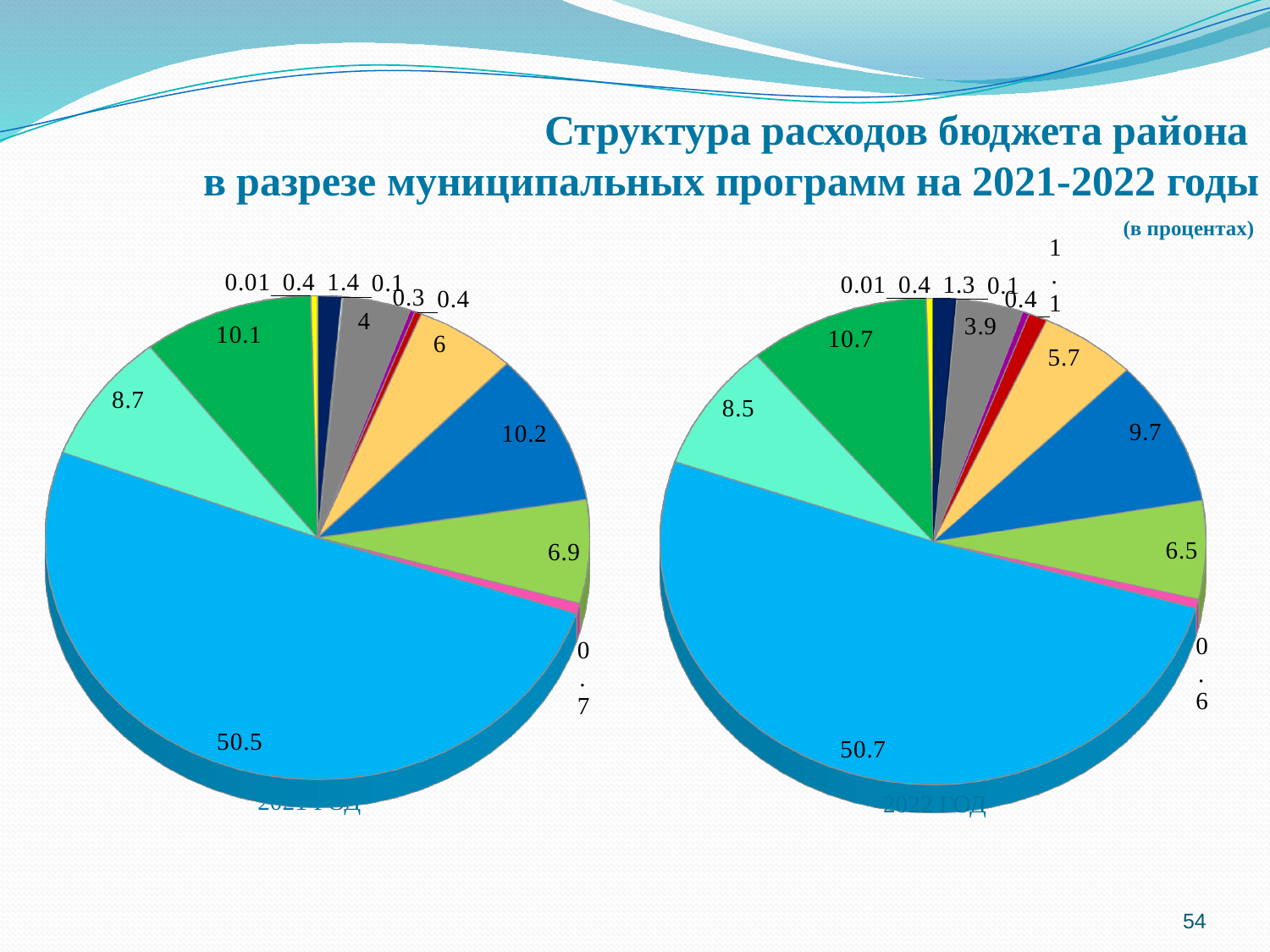
In what units are the values on the pie charts expressed, according to the note under the title? в процентах What type of chart is used on this slide for the 2021 ГОД and 2022 ГОД data? pie chart In the 2022 ГОД pie chart, what is the value of the largest slice? 50.7 What is the difference between the green slice in the 2022 ГОД pie chart (10.7) and the green slice in the 2021 ГОД pie chart (10.1)? 0.6 Which pie chart has the larger value for the dark blue slice: 2021 ГОД (10.2) or 2022 ГОД (9.7)? 2021 ГОД In the 2021 ГОД pie chart, what is the value of the light green slice on the right side? 6.9 In the 2022 ГОД pie chart, what is the value of the orange slice? 5.7 What is the difference between the largest slice in the 2022 ГОД pie chart and the largest slice in the 2021 ГОД pie chart? 0.2 In the 2021 ГОД pie chart, what is the value of the largest slice? 50.5 In the 2021 ГОД pie chart, what is the smallest labelled value? 0.01 In the 2022 ГОД pie chart, what is the value of the light green slice on the right side? 6.5 How many slices are labelled in the 2021 ГОД pie chart? 14